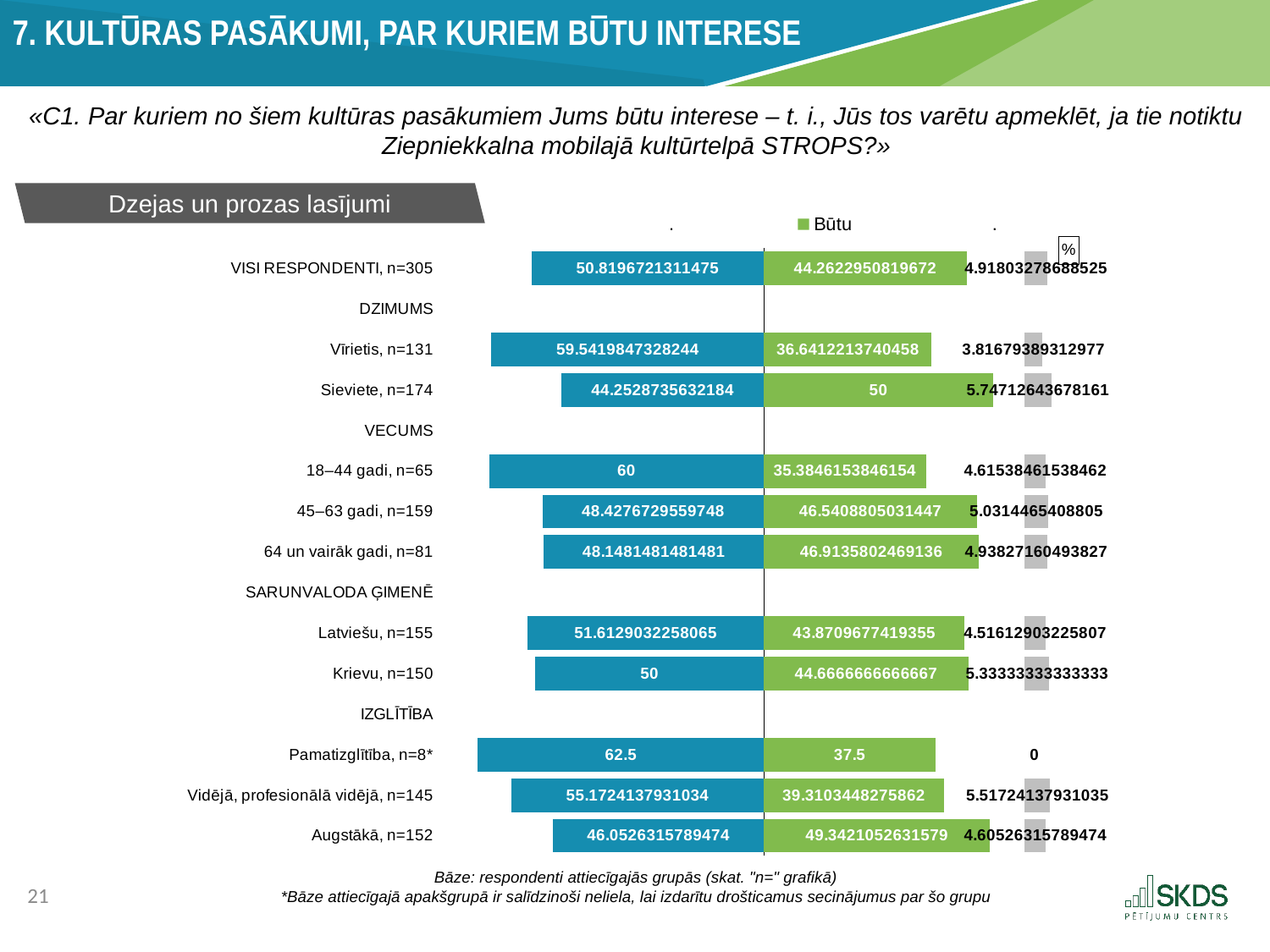
How many respondent groups have bars plotted in the chart? 11 What is the Būtu value for Sieviete, n=174? 50 For Pamatizglītība, n=8*, what is the difference between the blue segment value and the Būtu value? 25 What is the value of the blue (left) segment for 18–44 gadi, n=65? 60 What kind of chart is shown on the slide? Stacked bar chart Is the Būtu value larger for Vīrietis, n=131 or for Sieviete, n=174? Sieviete, n=174 Which group has the lowest Būtu value? 18–44 gadi, n=65 What is the Būtu value for Pamatizglītība, n=8*? 37.5 What is the value of the grey (right) segment for Pamatizglītība, n=8*? 0 Which group has the largest blue (left) segment? Pamatizglītība, n=8* What is the Būtu value for VISI RESPONDENTI, n=305? 44.2622950819672 Which group has the highest Būtu value? Sieviete, n=174